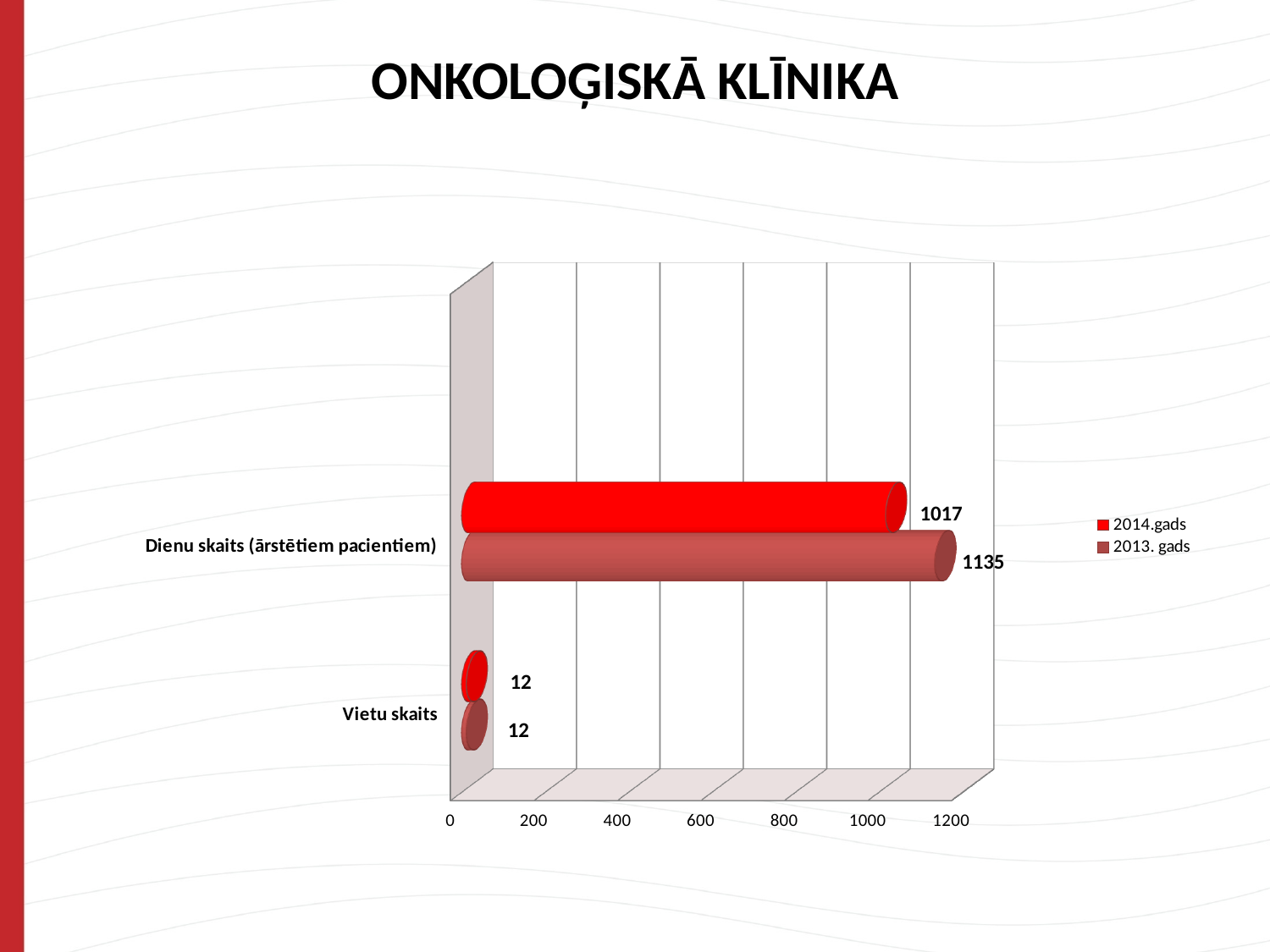
Which category has the highest value in the 2013. gads series? Dienu skaits (ārstētiem pacientiem) What kind of chart is shown on the slide? bar chart What is the difference between the 2013. gads and 2014.gads values for Dienu skaits (ārstētiem pacientiem)? 118 Which series has the larger value for Dienu skaits (ārstētiem pacientiem), 2014.gads or 2013. gads? 2013. gads How many series does the legend list? 2 What is the value for Vietu skaits in the 2014.gads series? 12 What is the title of the slide? ONKOLOĢISKĀ KLĪNIKA What is the value for Dienu skaits (ārstētiem pacientiem) in the 2014.gads series? 1017 How many categories are shown on the chart? 2 What is the value for Vietu skaits in the 2013. gads series? 12 Is the 2014.gads value for Dienu skaits (ārstētiem pacientiem) greater or less than 1000? greater What is the value for Dienu skaits (ārstētiem pacientiem) in the 2013. gads series? 1135